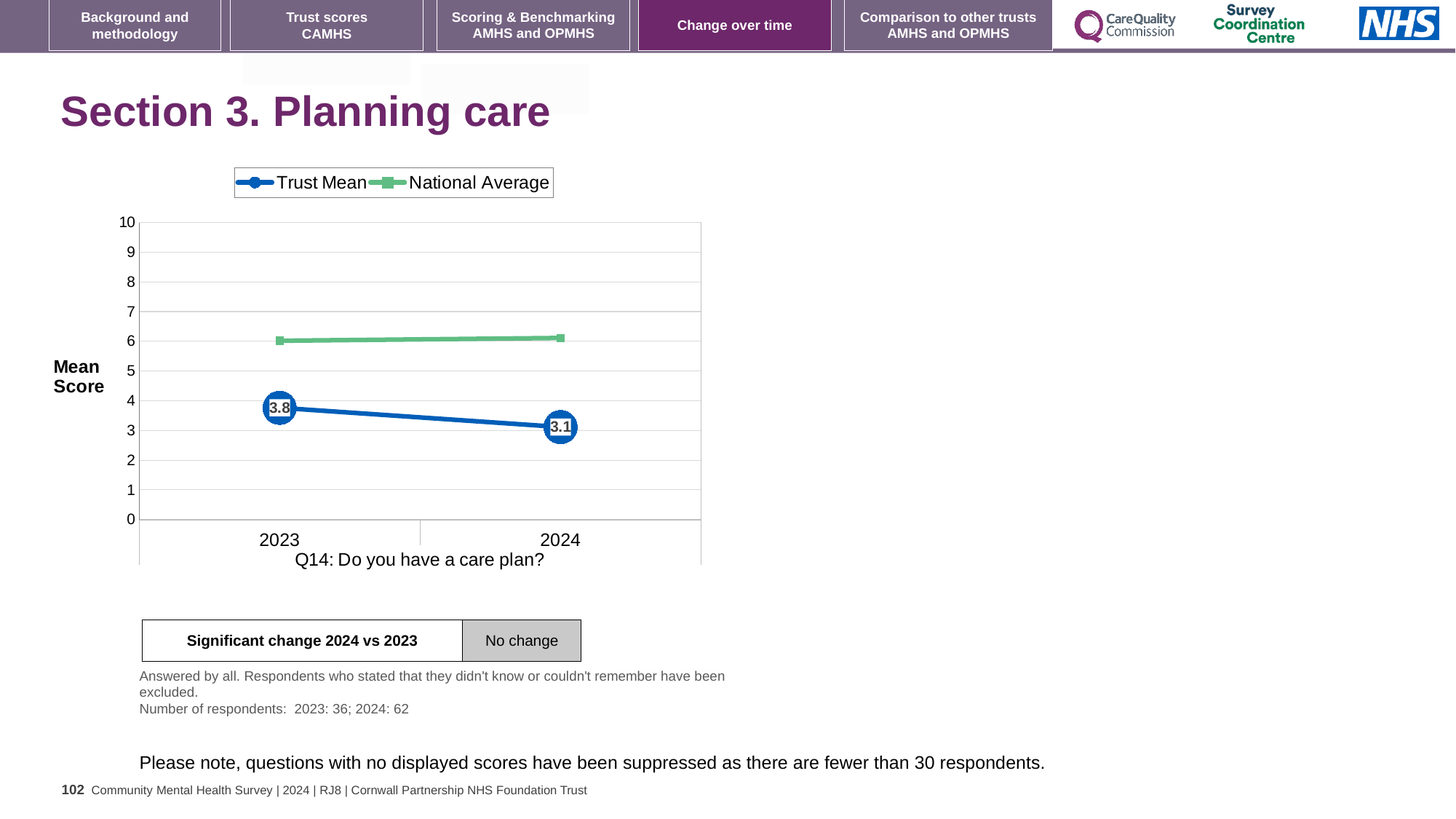
How many years are plotted on the x axis? 2 By how much did the Trust Mean score change from 2023 to 2024? 0.7 Which year has the higher Trust Mean score, 2023 or 2024? 2023 Is the Trust Mean value for 2024 greater or less than 4? less Does the Trust Mean rise or fall from 2023 to 2024? fall What kind of chart is shown on the slide? line chart How many series does the legend list? 2 What is the label of the y axis? Mean Score Is the National Average value for 2024 greater or less than 5? greater What is the Trust Mean score for 2024? 3.1 In 2023, which series has the higher value, Trust Mean or National Average? National Average What is the Trust Mean score for 2023? 3.8